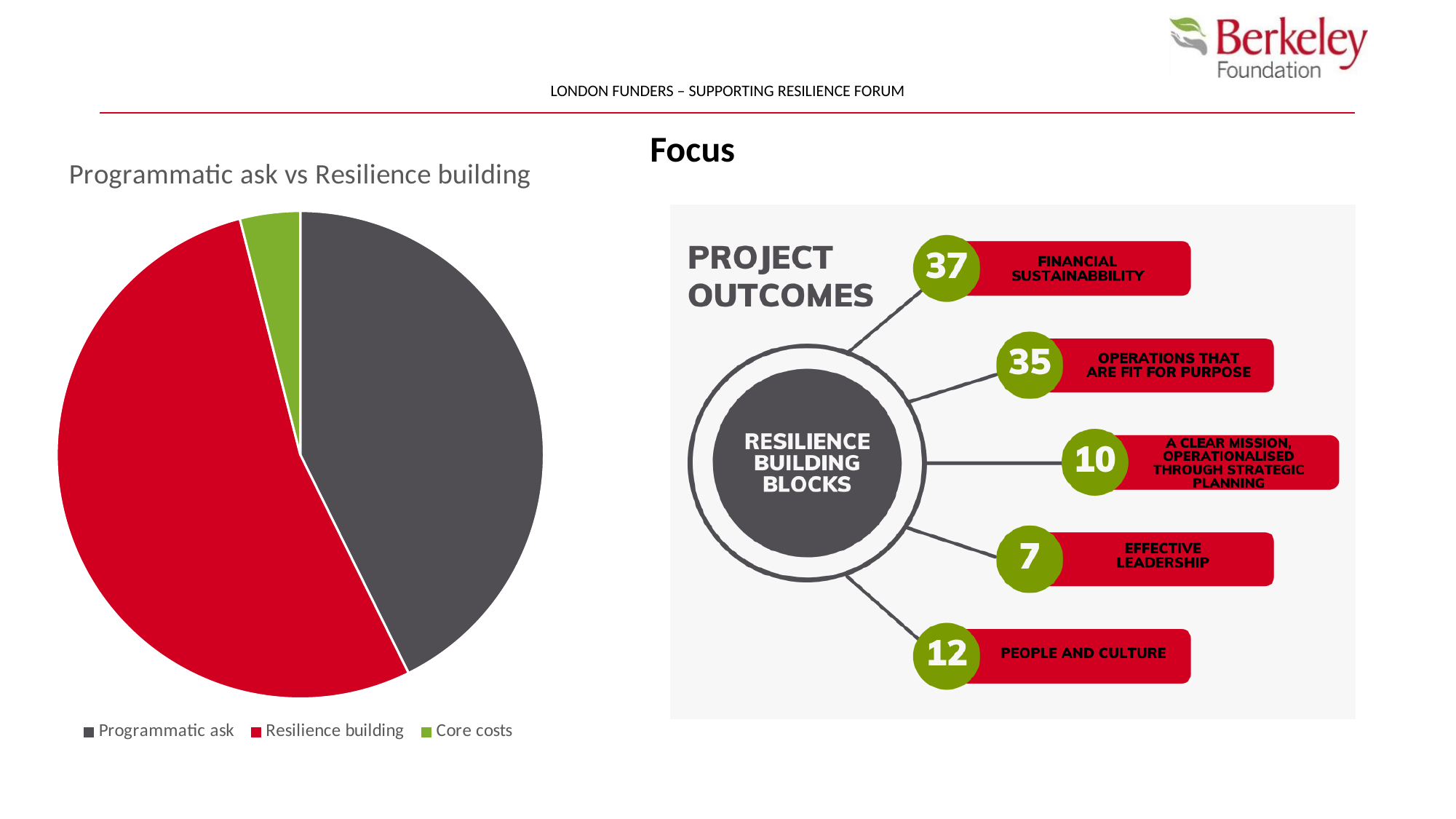
How many slices does the pie chart have? 3 Which slice of the pie chart is the largest? Resilience building In the pie chart, which is larger: Core costs or Programmatic ask? Programmatic ask Which slice of the pie chart is the smallest? Core costs What kind of chart is shown under the title "Programmatic ask vs Resilience building"? Pie chart What is the title of the pie chart? Programmatic ask vs Resilience building How many entries does the legend of the pie chart list? 3 In the pie chart, which is larger: Programmatic ask or Resilience building? Resilience building What colour is the Core costs slice in the pie chart? Green